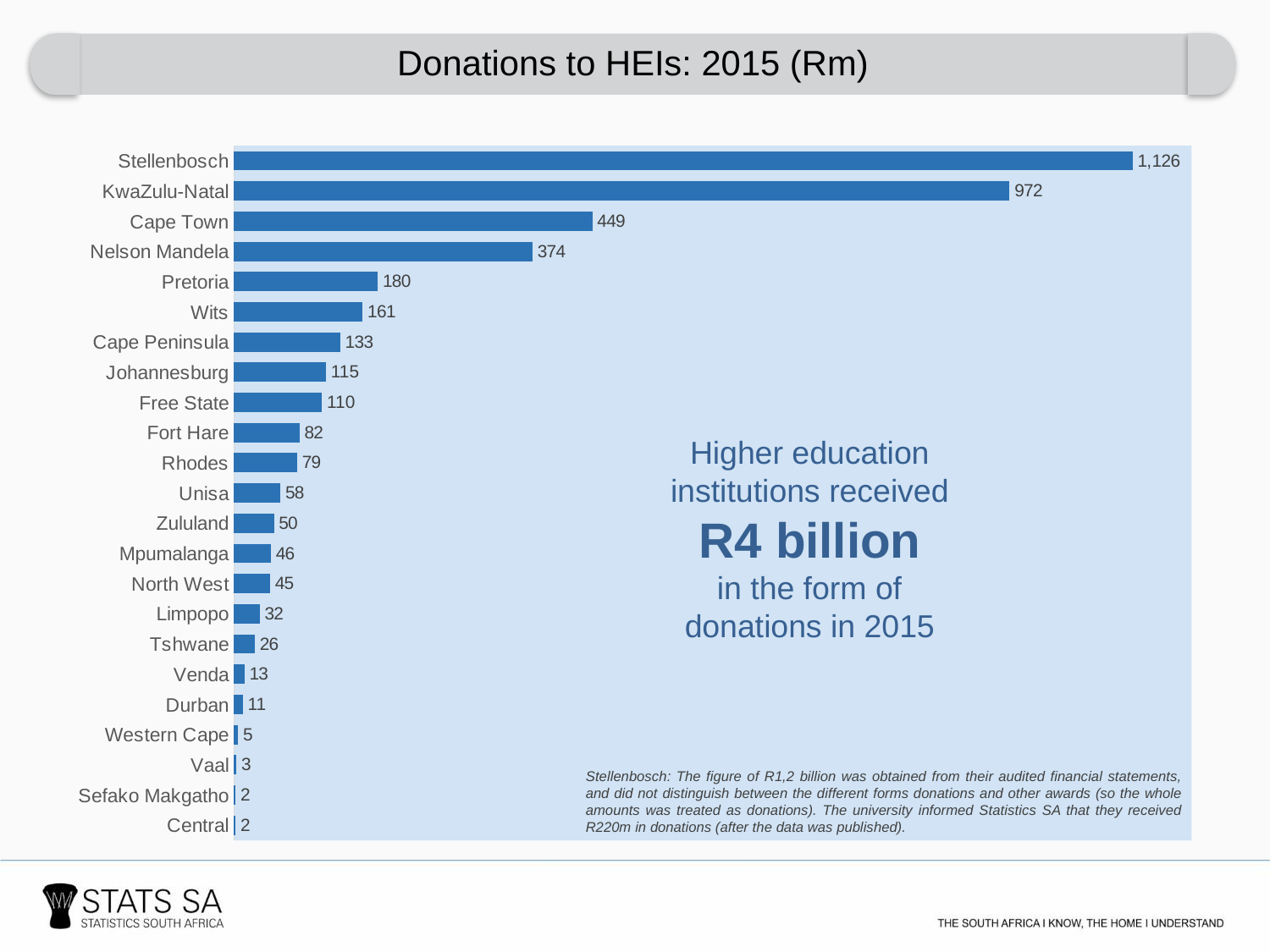
What kind of chart is shown on the slide? Bar chart What is the difference between the donation values for Stellenbosch and KwaZulu-Natal? 154 What is the donation value for Venda? 13 What is the donation value for Free State? 110 Which institution received the highest donations? Stellenbosch What is the title of the chart? Donations to HEIs: 2015 (Rm) What is the donation value for Cape Town? 449 Which received more donations, Zululand or Mpumalanga? Zululand What is the difference between the donation values for Pretoria and Wits? 19 According to the text on the chart, how much did higher education institutions receive in donations in 2015? R4 billion Which received more donations, Nelson Mandela or Cape Peninsula? Nelson Mandela How many institutions are shown in the chart? 23